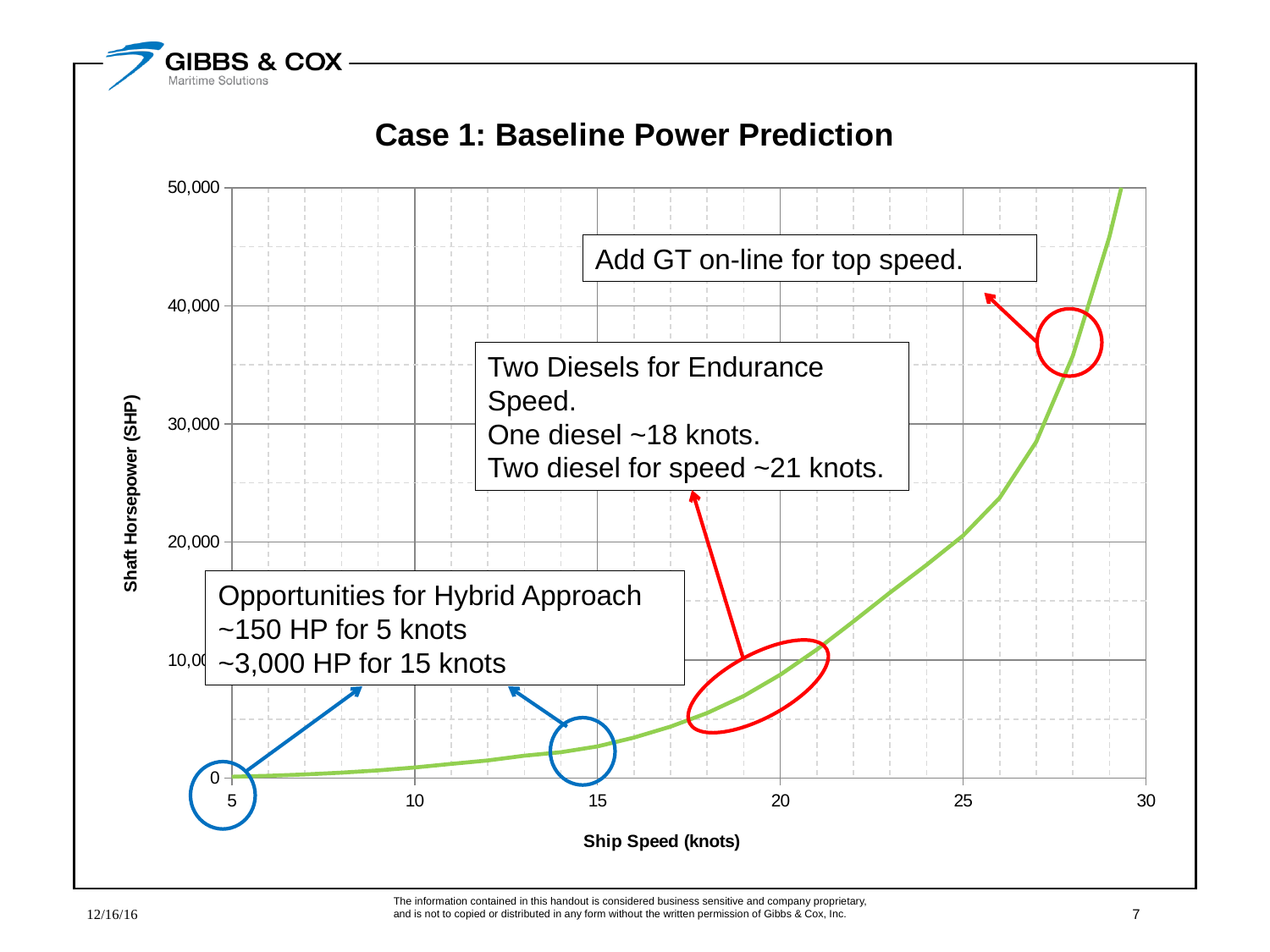
Is the shaft horsepower at 25 knots greater or less than 10,000? greater Is the shaft horsepower at 28 knots greater or less than 40,000? less Is the shaft horsepower at 20 knots greater or less than 10,000? less What is the title of the chart? Case 1: Baseline Power Prediction Which ship speed shown on the x axis has the higher shaft horsepower, 20 knots or 25 knots? 25 knots What is the label of the vertical axis? Shaft Horsepower (SHP) What kind of chart is shown on the slide? line chart Does the shaft horsepower rise or fall as ship speed increases along the x axis? rise What is the highest value shown on the vertical axis? 50,000